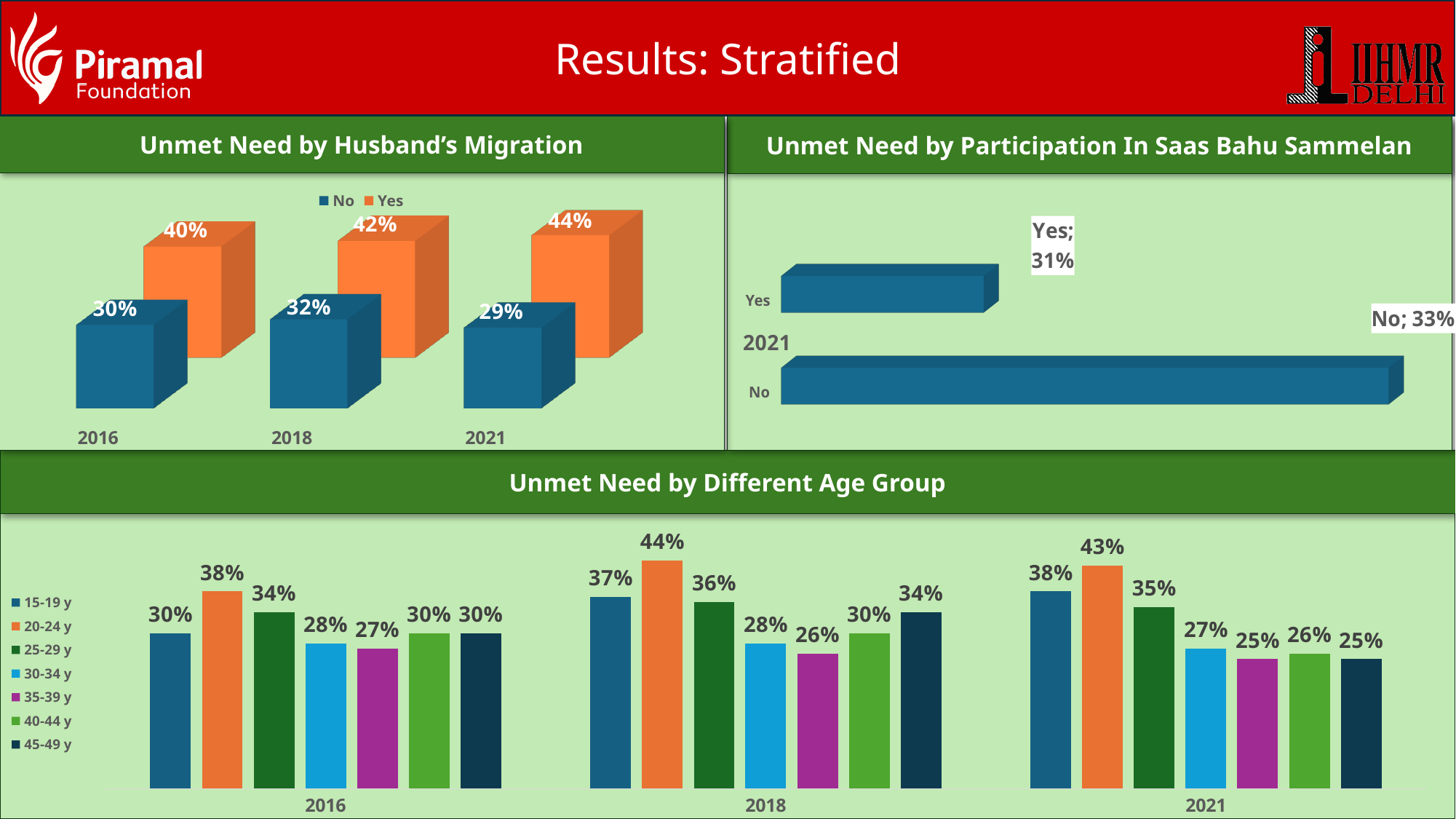
What kind of chart is 'Unmet Need by Participation In Saas Bahu Sammelan'? bar chart In the 'Unmet Need by Husband's Migration' chart, what is the difference between 'Yes' and 'No' in 2016? 10% In the 'Unmet Need by Husband's Migration' chart, what is the value for 'No' in 2018? 32% In the 'Unmet Need by Husband's Migration' chart, do the 'Yes' values rise or fall from 2016 to 2021? rise In the 'Unmet Need by Participation In Saas Bahu Sammelan' chart, what is the value for 'No'? 33% In the 'Unmet Need by Different Age Group' chart, what is the value for the 20-24 y group in 2018? 44% In the 'Unmet Need by Participation In Saas Bahu Sammelan' chart, which category is higher, 'Yes' or 'No'? No In the 'Unmet Need by Husband's Migration' chart, what is the value for 'Yes' in 2021? 44% In the 'Unmet Need by Different Age Group' chart, which age group has the lowest value in 2021? 35-39 y and 45-49 y (25%) In the 'Unmet Need by Different Age Group' chart, what is the difference between the 20-24 y and 35-39 y values in 2016? 11% In the 'Unmet Need by Husband's Migration' chart, how many series does the legend list? 2 In the 'Unmet Need by Different Age Group' chart, how many age groups does the legend list? 7